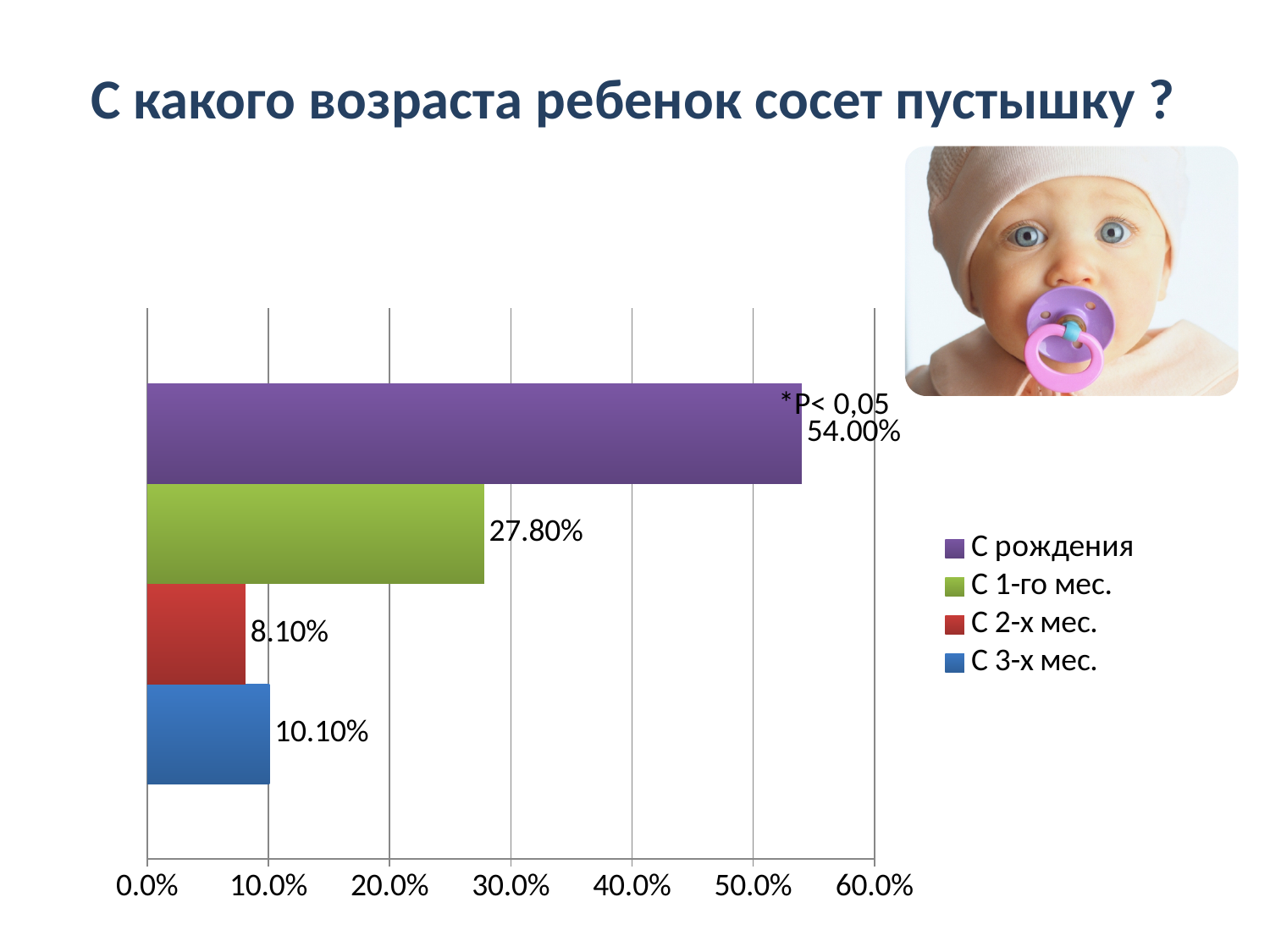
What is the difference between the values for "С рождения" and "С 1-го мес."? 26.20% What is the difference between the values for "С 3-х мес." and "С 2-х мес."? 2.00% What is the value for "С рождения"? 54.00% What is the value for "С 2-х мес."? 8.10% What is the value for "С 3-х мес."? 10.10% What is the title of the slide? С какого возраста ребенок сосет пустышку ? Which is larger, the value for "С 3-х мес." or the value for "С 2-х мес."? С 3-х мес. Which category has the lowest value? С 2-х мес. Which category has the highest value? С рождения What is the value for "С 1-го мес."? 27.80% What kind of chart is shown on the slide? Bar chart How many bars are shown in the chart? 4